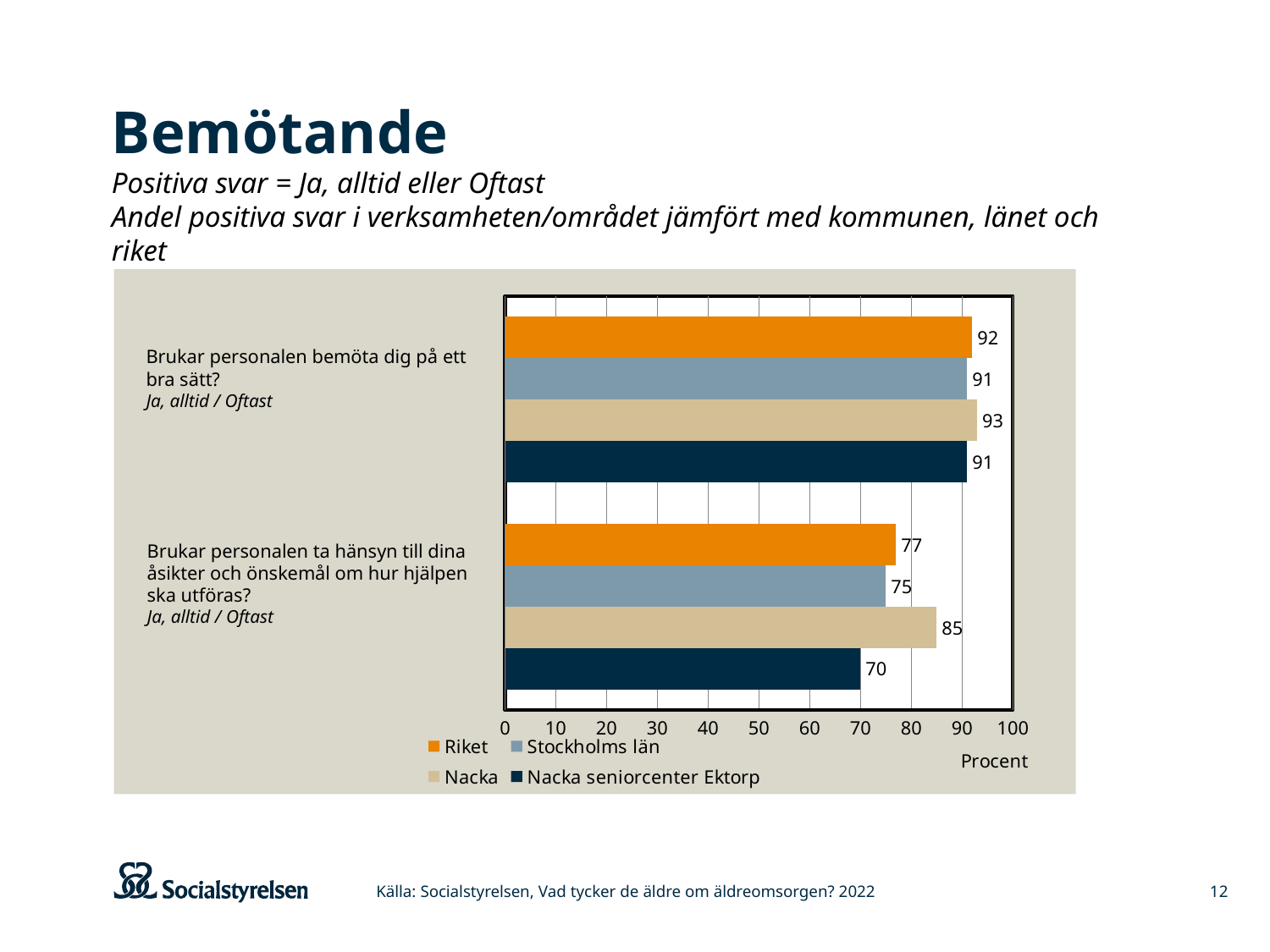
Which series has the lowest value for the question 'Brukar personalen ta hänsyn till dina åsikter och önskemål om hur hjälpen ska utföras?'? Nacka seniorcenter Ektorp What is the value for Nacka seniorcenter Ektorp for the question 'Brukar personalen ta hänsyn till dina åsikter och önskemål om hur hjälpen ska utföras?'? 70 What is the difference between the Nacka and Nacka seniorcenter Ektorp values for the question 'Brukar personalen ta hänsyn till dina åsikter och önskemål om hur hjälpen ska utföras?'? 15 What is the value for Stockholms län for the question 'Brukar personalen bemöta dig på ett bra sätt?'? 91 What label is shown on the horizontal axis of the chart? Procent Which series has the highest value for the question 'Brukar personalen ta hänsyn till dina åsikter och önskemål om hur hjälpen ska utföras?'? Nacka For the question 'Brukar personalen ta hänsyn till dina åsikter och önskemål om hur hjälpen ska utföras?', which is larger: Riket or Stockholms län? Riket What is the value for Riket for the question 'Brukar personalen bemöta dig på ett bra sätt?'? 92 How many survey questions (categories) are shown in the chart? 2 What is the value for Nacka for the question 'Brukar personalen ta hänsyn till dina åsikter och önskemål om hur hjälpen ska utföras?'? 85 How many series does the legend list? 4 What kind of chart is shown on the slide? bar chart